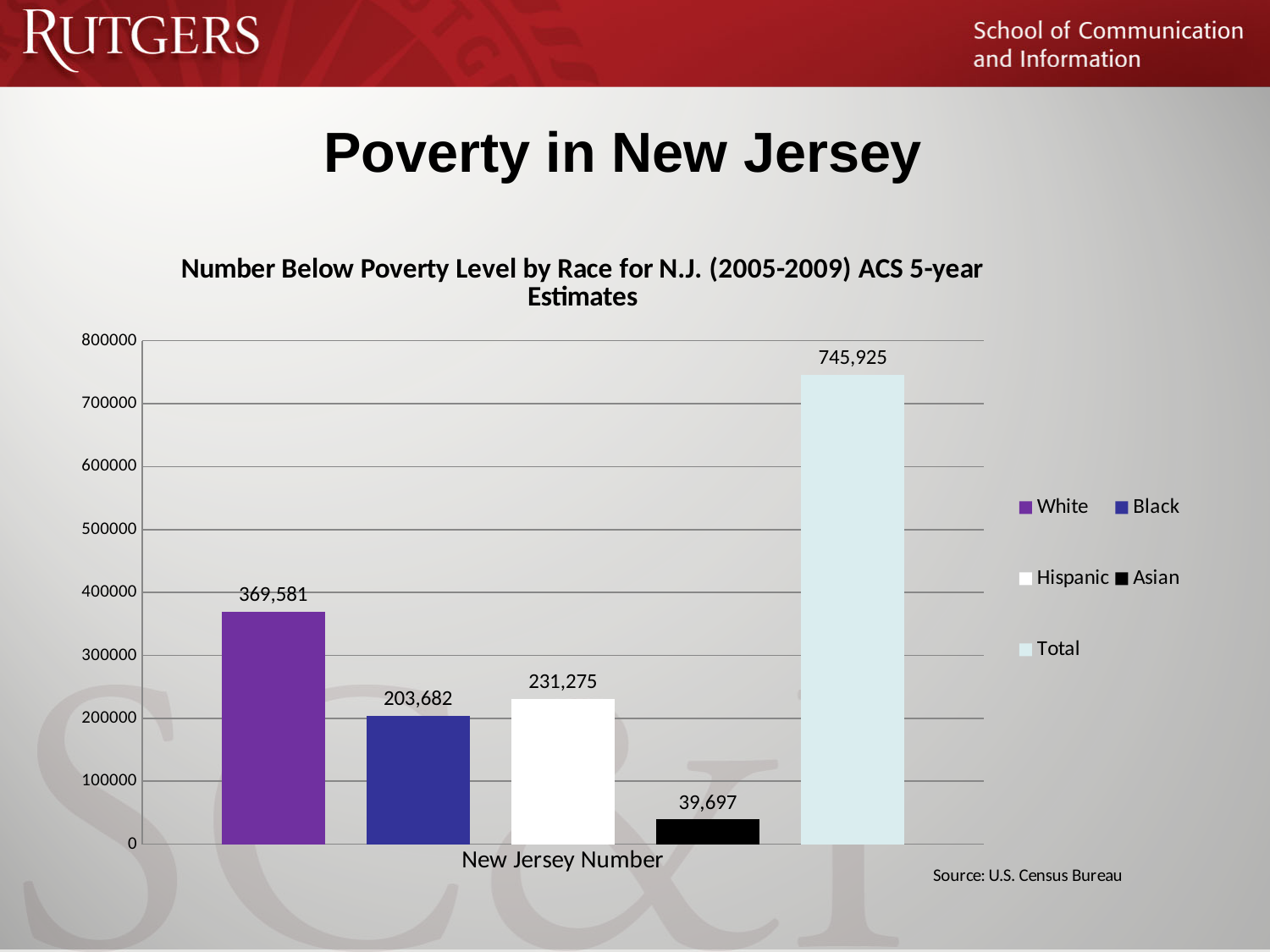
How many series does the legend list? 5 Which series has the lowest value in the chart? Asian What is the value for Asian in the chart? 39,697 What is the value for Hispanic in the chart? 231,275 What is the value for White in the chart? 369,581 What is the value for Black in the chart? 203,682 Among the race groups (excluding Total), which has the highest number below the poverty level? White What kind of chart is shown on the slide? Bar chart Which is larger, the value for Hispanic or the value for Black? Hispanic What is the difference between the Hispanic and Black values? 27,593 What is the value for Total in the chart? 745,925 What is the difference between the White and Black values? 165,899